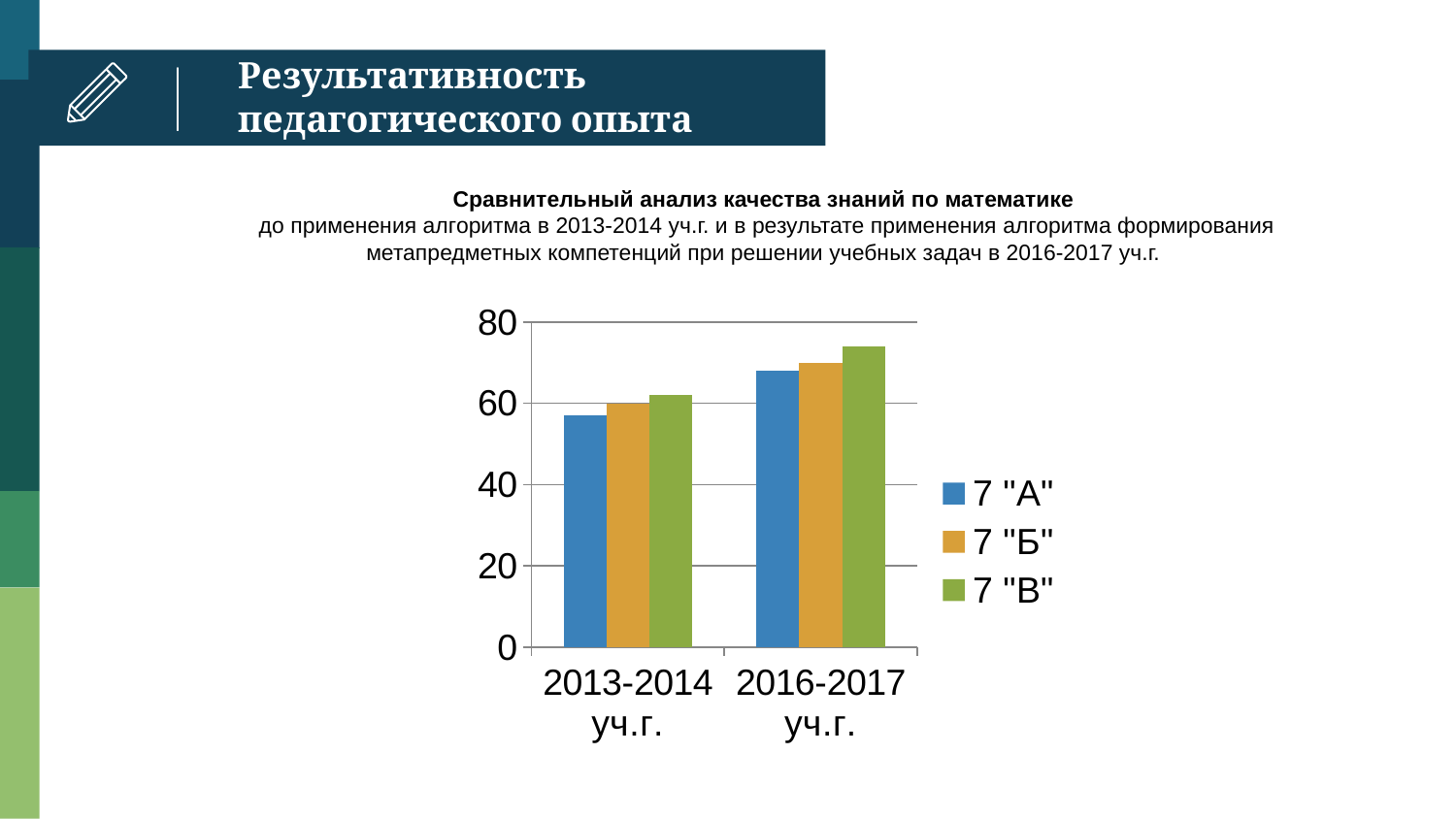
Which series has the highest value in 2016-2017 уч.г.? 7 "В" What kind of chart is shown on the slide? bar chart How many series does the legend list? 3 Is the value for 7 "А" in 2013-2014 уч.г. greater or less than 60? less Is the value for 7 "В" in 2016-2017 уч.г. greater or less than 60? greater Which series has the lowest value in 2013-2014 уч.г.? 7 "А" Do the values for 7 "А" rise or fall from 2013-2014 уч.г. to 2016-2017 уч.г.? rise Is the value for 7 "А" in 2016-2017 уч.г. greater or less than 80? less Which series does the legend list first? 7 "А" Which colour represents the 7 "В" series? green How many categories are shown on the x axis? 2 Which is larger for 7 "В": the value in 2013-2014 уч.г. or in 2016-2017 уч.г.? 2016-2017 уч.г.